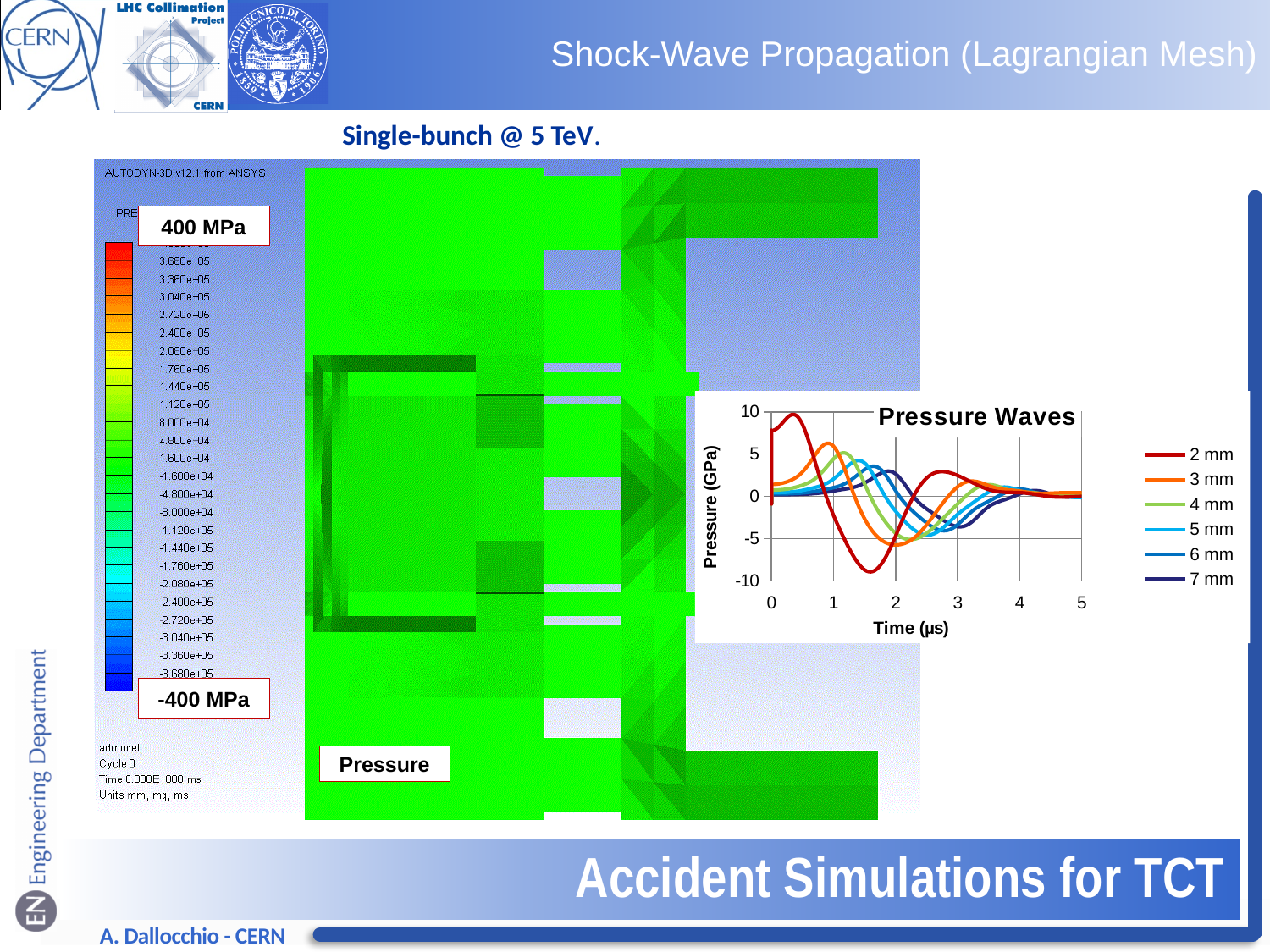
In the "Pressure Waves" chart, is the minimum pressure of the 2 mm series greater or less than -5 GPa? less In the "Pressure Waves" chart, is the peak pressure of the 2 mm series greater or less than 5 GPa? greater In the "Pressure Waves" chart, is the peak pressure of the 3 mm series greater or less than 5 GPa? greater In the "Pressure Waves" chart, which series reaches its first peak earliest in time? 2 mm In the "Pressure Waves" chart, which series has the larger peak pressure, 2 mm or 7 mm? 2 mm What is the title of the line chart on the slide? Pressure Waves What is the label of the y axis of the "Pressure Waves" chart? Pressure (GPa) What kind of chart is the "Pressure Waves" chart? line chart In the "Pressure Waves" chart, which series reaches the highest peak pressure? 2 mm How many series does the legend of the "Pressure Waves" chart list? 6 In the "Pressure Waves" chart, which series reaches the lowest (most negative) pressure? 2 mm